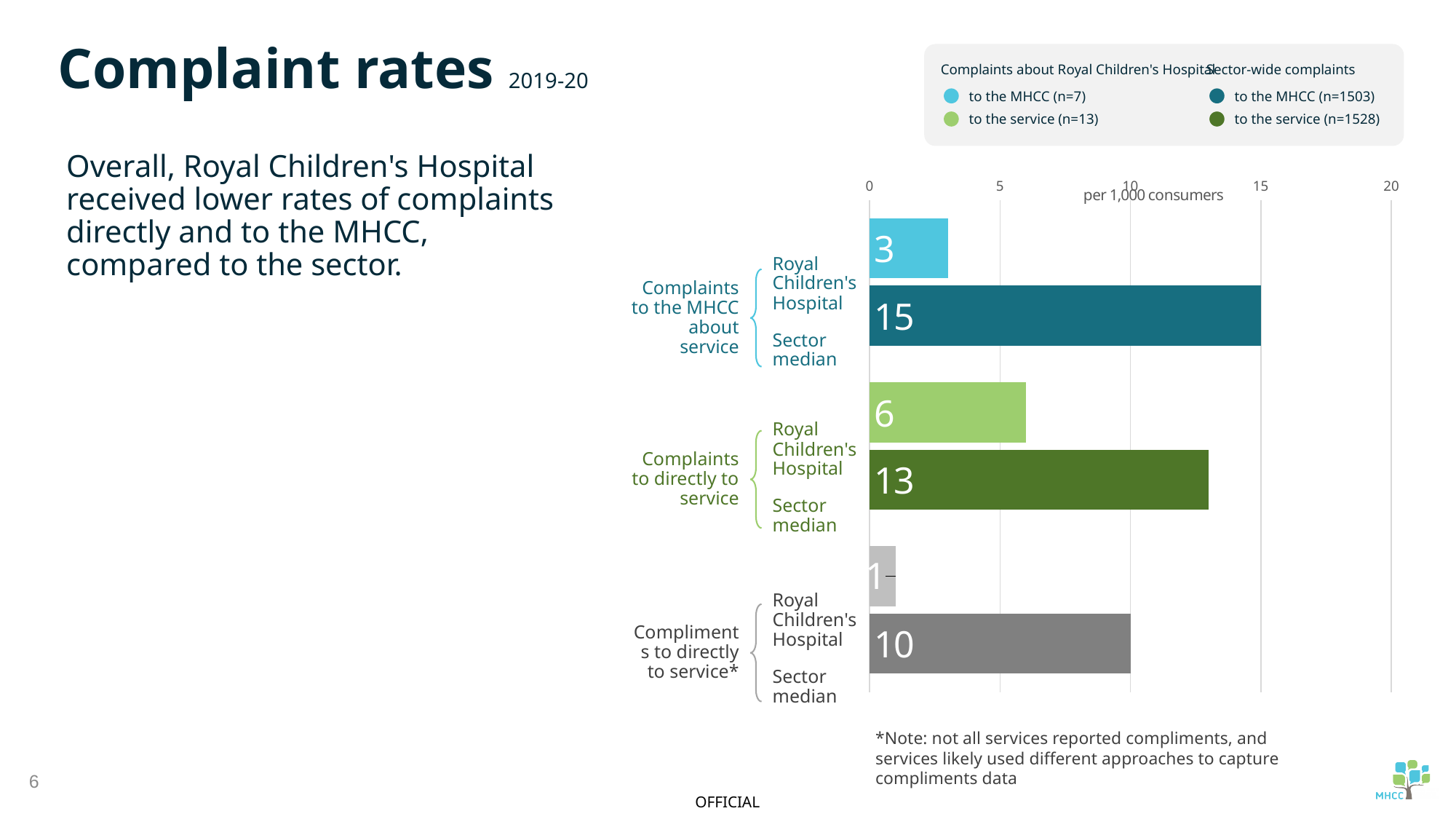
What unit is the chart's axis measured in? per 1,000 consumers What is the difference between the sector median and Royal Children's Hospital for complaints to the MHCC about service? 12 What is the rate of complaints directly to service for Royal Children's Hospital? 6 What kind of chart is shown on the slide? Bar chart What is the sector median rate of compliments directly to service? 10 What is the difference between the sector median and Royal Children's Hospital for complaints directly to service? 7 What is the sector median rate of complaints to the MHCC about service? 15 What is the sector median rate of complaints directly to service? 13 Which is larger: Royal Children's Hospital's rate of complaints directly to service or its rate of complaints to the MHCC about service? Complaints directly to service Which bar in the chart has the highest value? Sector median, complaints to the MHCC about service Which bar in the chart has the lowest value? Royal Children's Hospital, compliments directly to service What is the rate of complaints to the MHCC about service for Royal Children's Hospital? 3